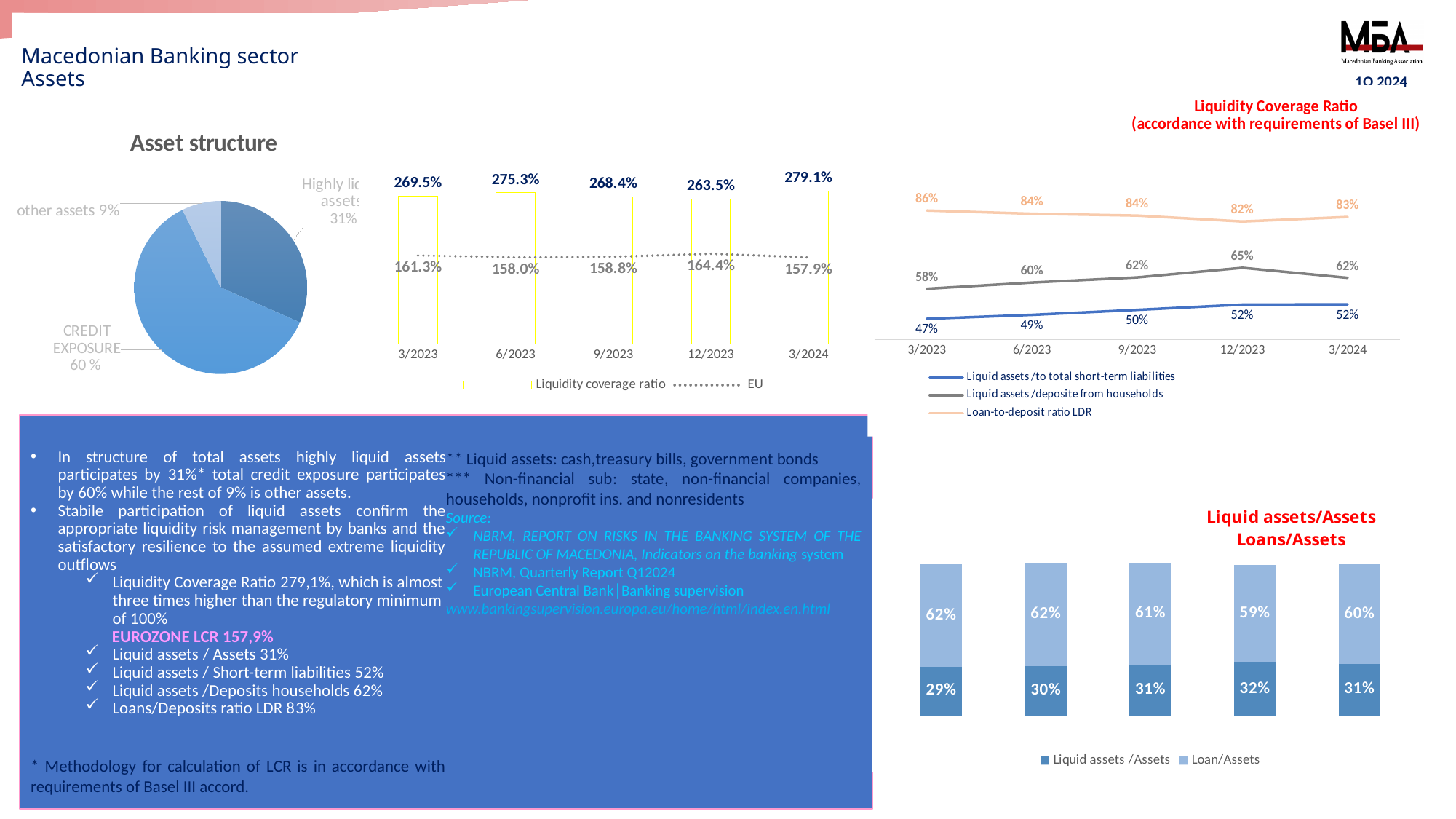
In the Liquidity coverage ratio chart, what is the EU value for 12/2023? 164.4% In the Liquidity coverage ratio chart, which period has the lowest Liquidity coverage ratio? 12/2023 What kind of chart is the Asset structure chart? Pie chart In the Liquidity coverage ratio chart, what is the difference between the Liquidity coverage ratio and the EU value for 3/2024? 121.2% In the Liquidity Coverage Ratio (accordance with requirements of Basel III) line chart, what is the Loan-to-deposit ratio LDR for 3/2023? 86% In the Asset structure pie chart, what share is credit exposure? 60 % In the Liquid assets/Assets Loans/Assets stacked bar chart, what is the total of the second bar? 92% In the Liquidity Coverage Ratio (accordance with requirements of Basel III) line chart, in which period does Liquid assets /deposite from households reach its highest value? 12/2023 In the Liquidity coverage ratio chart, what is the Liquidity coverage ratio for 3/2024? 279.1% In the Asset structure pie chart, what share is other assets? 9% In the Liquid assets/Assets Loans/Assets stacked bar chart, what is the Liquid assets /Assets value for the fourth bar? 32% How many series does the legend of the Liquidity Coverage Ratio (accordance with requirements of Basel III) line chart list? 3